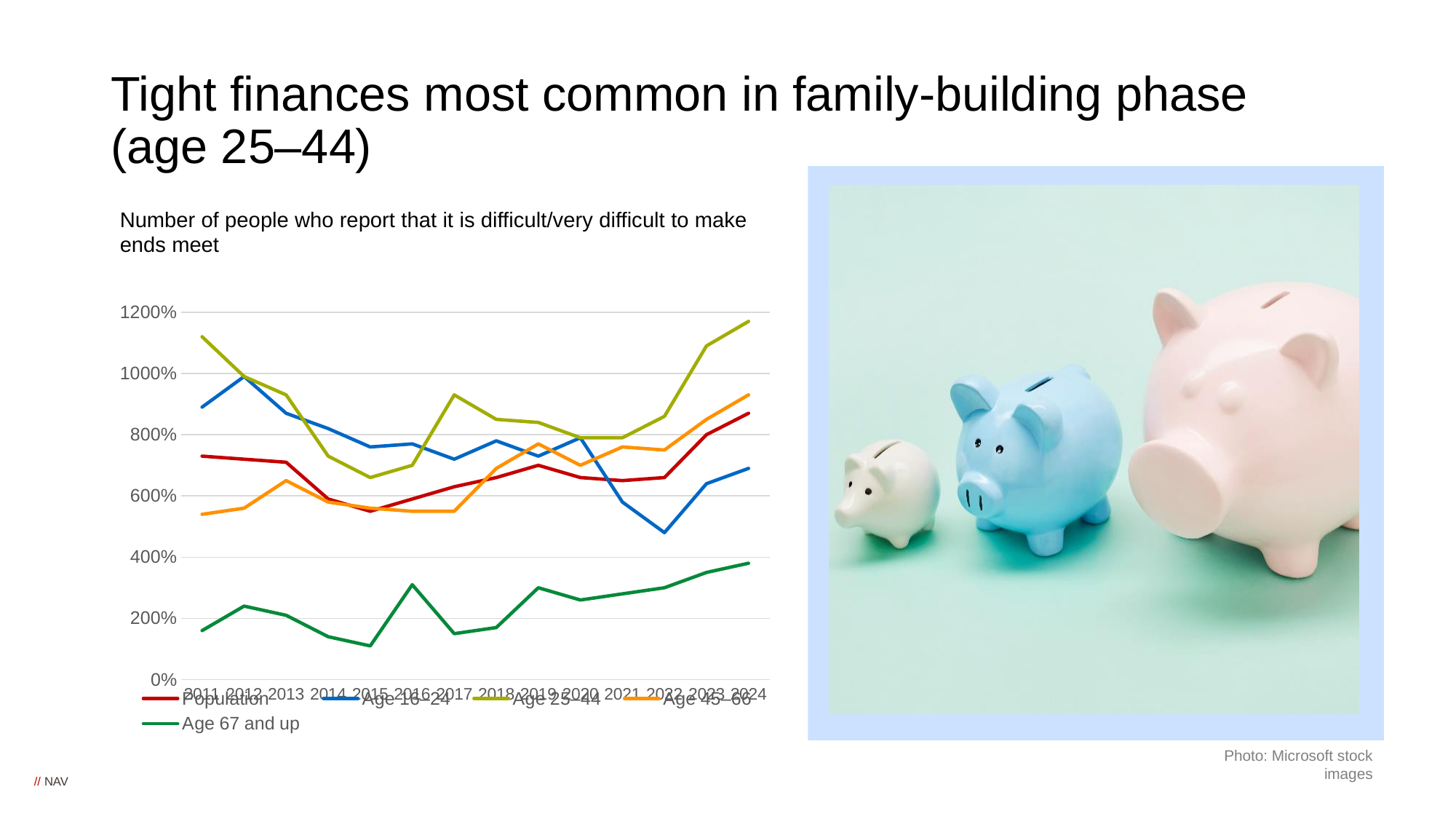
In 2024, which is larger: the value for Population or the value for Age 16–24? Population How many series does the chart's legend list? 5 Which series has the highest value in 2024? Age 25–44 Does the Age 25–44 line rise or fall from 2021 to 2024? Rises Is the value for Age 67 and up in 2015 greater or less than 200%? less Is the value for Age 16–24 in 2022 greater or less than 600%? less Which series has the highest value in 2011? Age 25–44 Which series has the lowest value in 2024? Age 67 and up How many years are plotted along the x axis of the chart? 14 What colour is the line for Age 67 and up? Green Is the value for Age 25–44 in 2024 greater or less than 1000%? greater What kind of chart is shown on the slide? Line chart